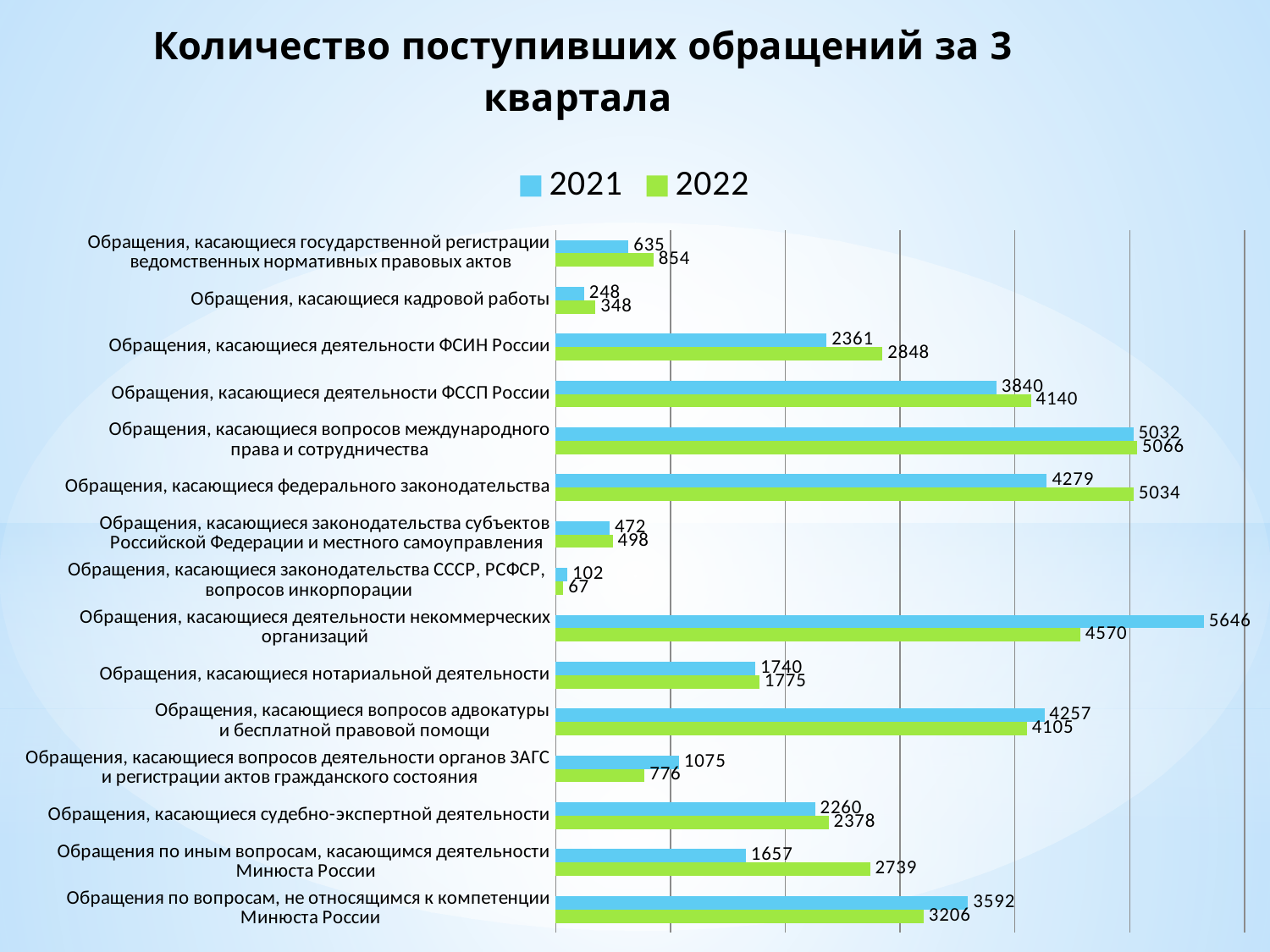
What is the 2022 value for «Обращения, касающиеся деятельности ФСИН России»? 2848 Which category has the lowest 2022 value? Обращения, касающиеся законодательства СССР, РСФСР, вопросов инкорпорации What is the difference between the 2022 and 2021 values for «Обращения, касающиеся деятельности ФСИН России»? 487 What is the title of the chart on the slide? Количество поступивших обращений за 3 квартала What is the 2022 value for «Обращения по иным вопросам, касающимся деятельности Минюста России»? 2739 How many series does the legend list? 2 For «Обращения, касающиеся деятельности некоммерческих организаций», which year has the larger value, 2021 or 2022? 2021 What is the 2021 value for «Обращения, касающиеся нотариальной деятельности»? 1740 What kind of chart is shown on the slide? bar chart What is the difference between the 2022 and 2021 values for «Обращения по иным вопросам, касающимся деятельности Минюста России»? 1082 How many categories are plotted in the chart? 15 Which category has the highest 2021 value? Обращения, касающиеся деятельности некоммерческих организаций